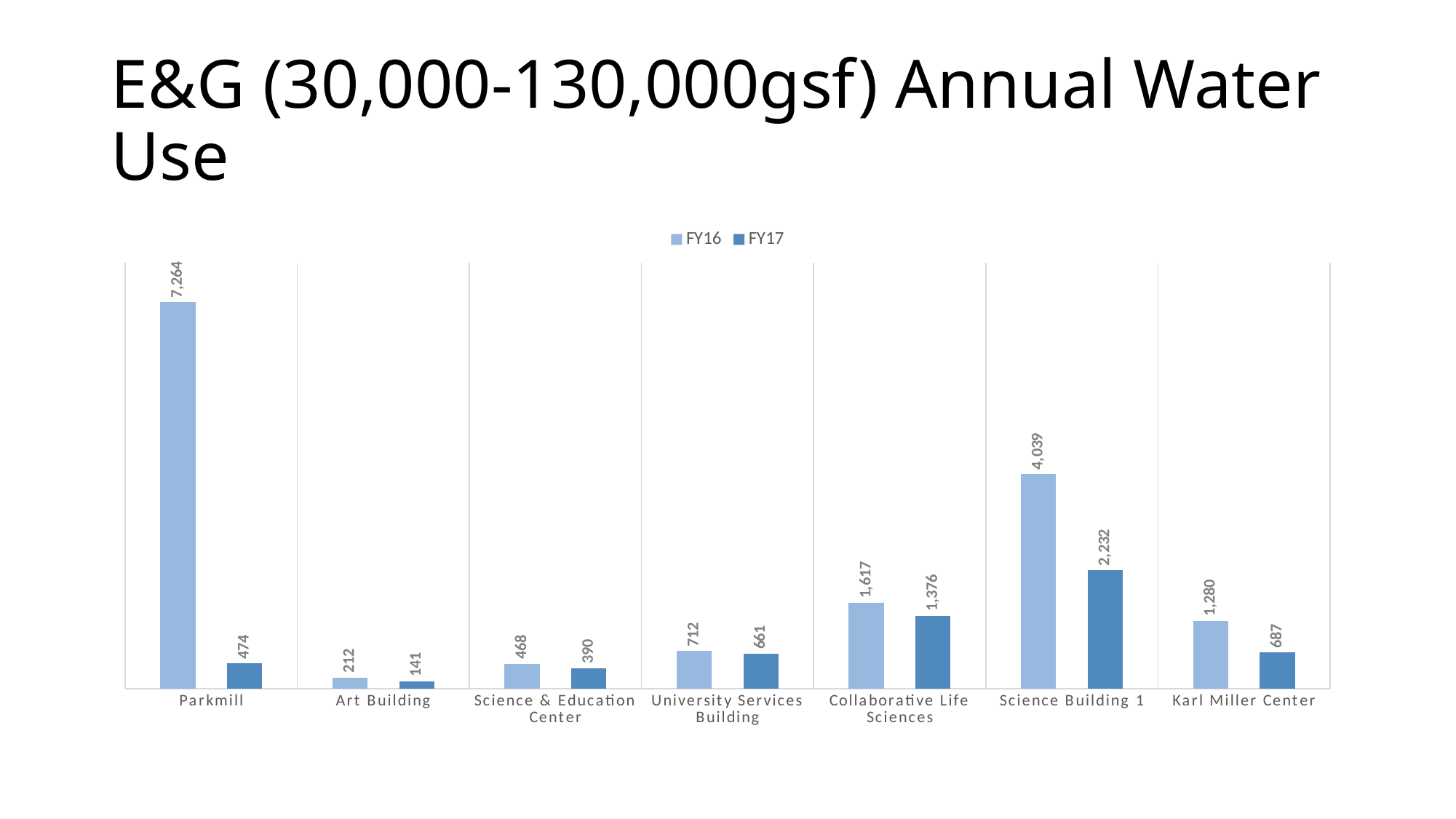
What is the difference between the FY16 and FY17 values for Parkmill? 6,790 What is the difference between the FY16 and FY17 values for Collaborative Life Sciences? 241 Which is larger, the FY17 value for University Services Building or the FY17 value for Karl Miller Center? Karl Miller Center What is the FY16 value for Karl Miller Center? 1,280 What is the title of the slide? E&G (30,000-130,000gsf) Annual Water Use What is the FY16 value for Parkmill? 7,264 What kind of chart is shown on the slide? Bar chart How many series does the legend list? 2 Which building has the lowest FY17 value? Art Building Which building has the highest FY16 value? Parkmill How many buildings are shown on the x axis? 7 What is the FY17 value for Science Building 1? 2,232